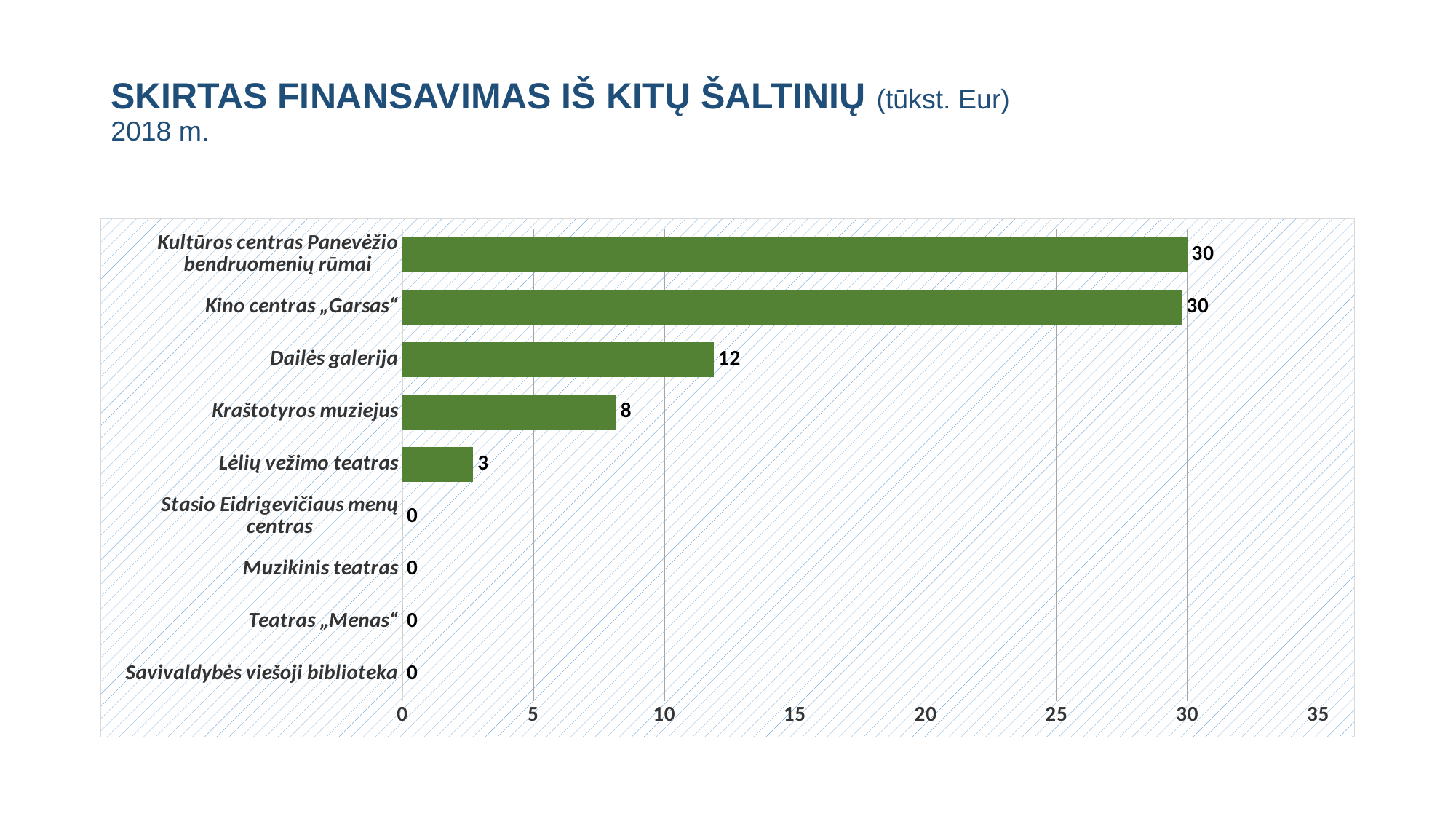
What is the value for Kultūros centras Panevėžio bendruomenių rūmai? 30 What is the difference between the values for Dailės galerija and Kraštotyros muziejus? 4 What unit is given in the chart title? tūkst. Eur What is the value for Lėlių vežimo teatras? 3 Which has a larger value, Dailės galerija or Kraštotyros muziejus? Dailės galerija How many categories are shown on the chart? 9 What is the value for Kraštotyros muziejus? 8 What is the difference between the values for Kino centras „Garsas“ and Lėlių vežimo teatras? 27 What kind of chart is shown on the slide? bar chart Is the value for Dailės galerija greater or less than 10? greater What is the value for Muzikinis teatras? 0 What is the value for Dailės galerija? 12